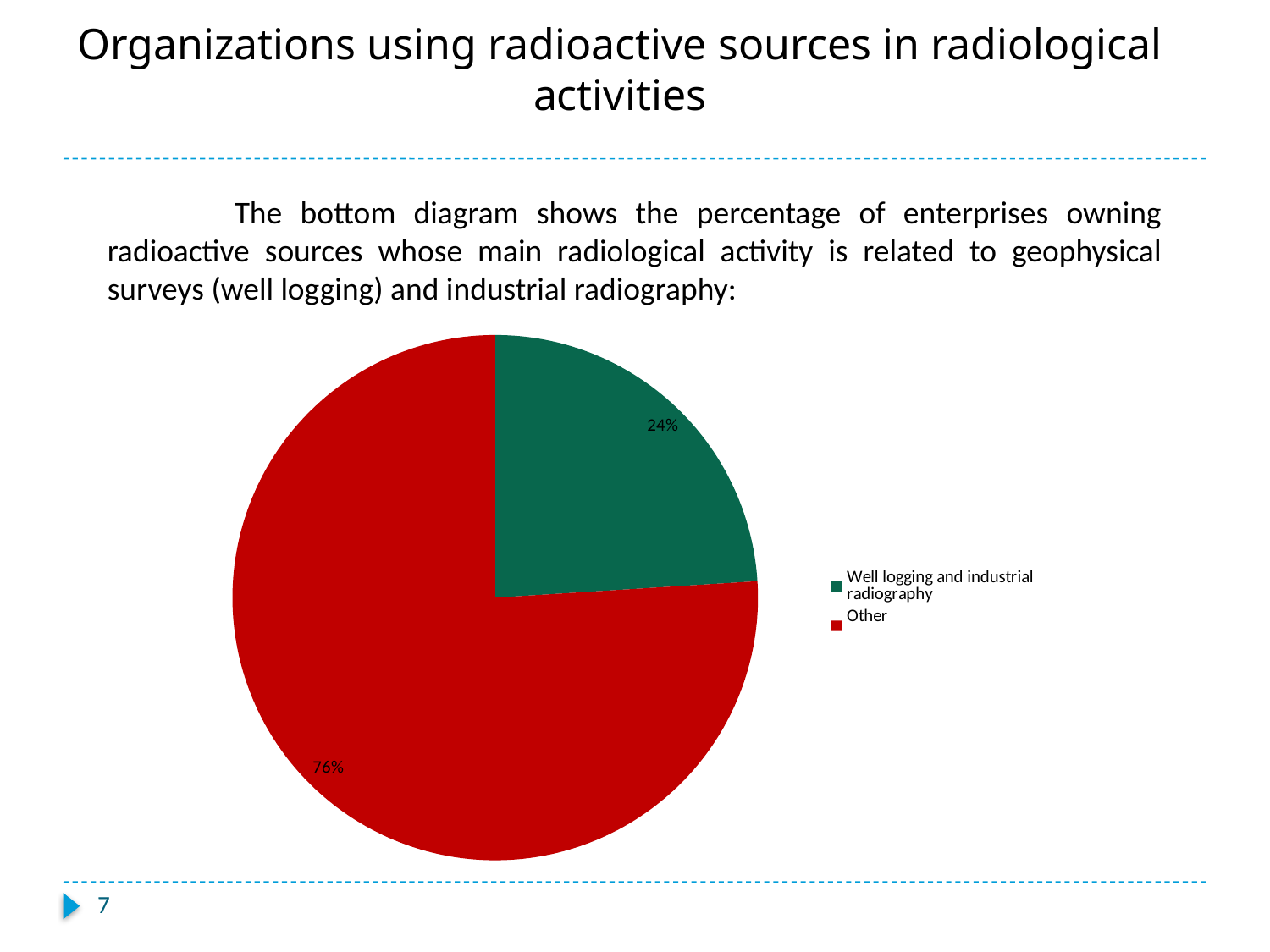
What percentage of the pie is labelled for Other? 76% Which slice of the pie is the largest? Other What share of the pie does the Well logging and industrial radiography slice represent? 24% What colour is the Other slice in the pie chart? red What colour is the Well logging and industrial radiography slice in the pie chart? green What kind of chart is shown on the slide? pie chart Which slice of the pie is the smallest? Well logging and industrial radiography What is the difference in percentage points between the Other slice and the Well logging and industrial radiography slice? 52 Which is larger: the Other slice or the Well logging and industrial radiography slice? Other How many entries does the legend list? 2 What percentage of the pie is labelled for Well logging and industrial radiography? 24% How many slices does the pie chart have? 2